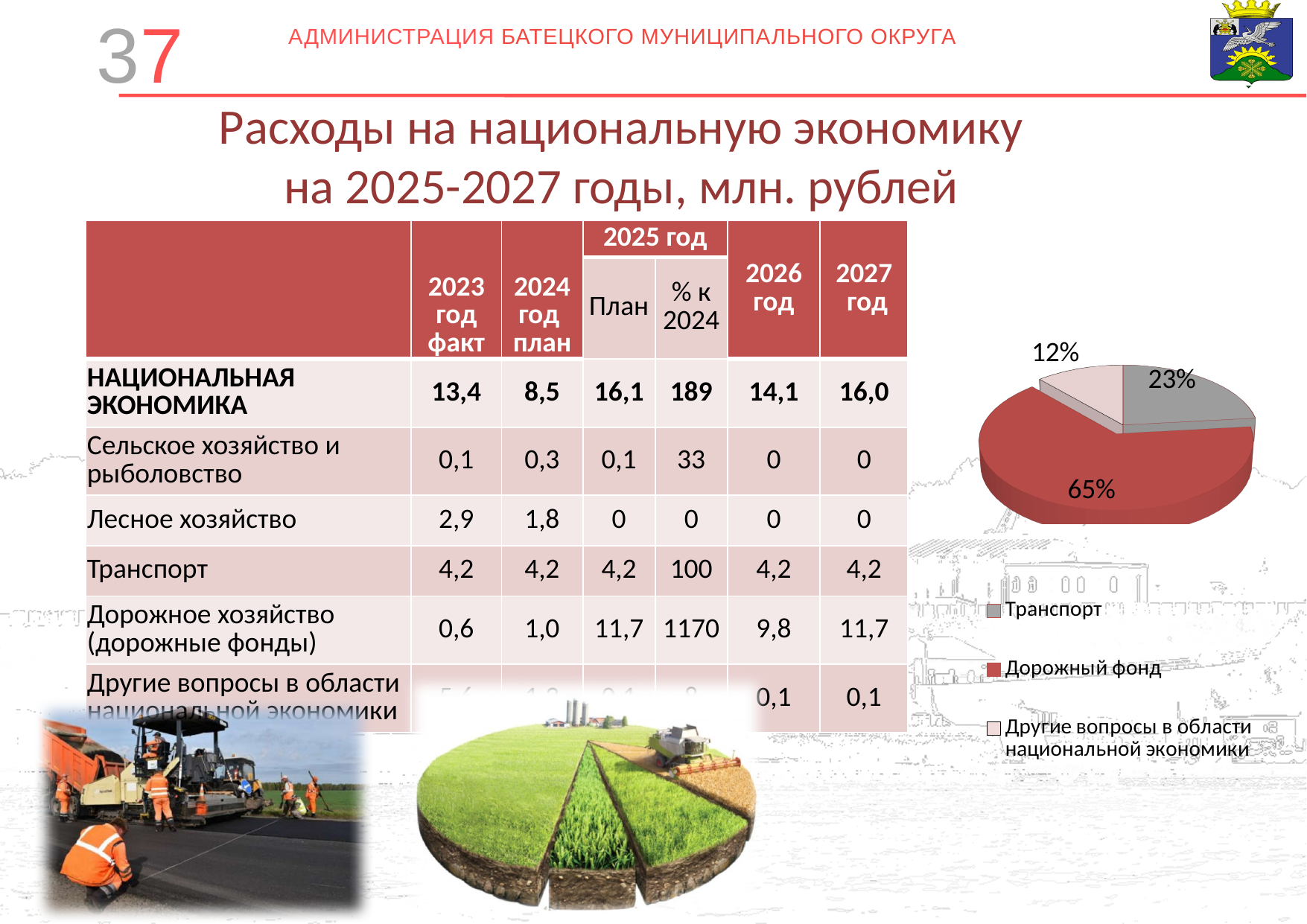
What kind of chart is shown on the right side of the slide? pie chart In the pie chart, what is the difference in percentage points between Дорожный фонд and Транспорт? 42 Which slice of the pie chart is the smallest? Другие вопросы в области национальной экономики What colour is the Дорожный фонд slice in the pie chart? red How many slices does the pie chart have? 3 What colour is the Транспорт slice in the pie chart? grey How many entries does the pie chart legend list? 3 Which slice of the pie chart is the largest? Дорожный фонд In the pie chart, which is larger: Транспорт or Другие вопросы в области национальной экономики? Транспорт What share of the pie chart does Другие вопросы в области национальной экономики have? 12% What share of the pie chart does Транспорт have? 23% What share of the pie chart does Дорожный фонд have? 65%